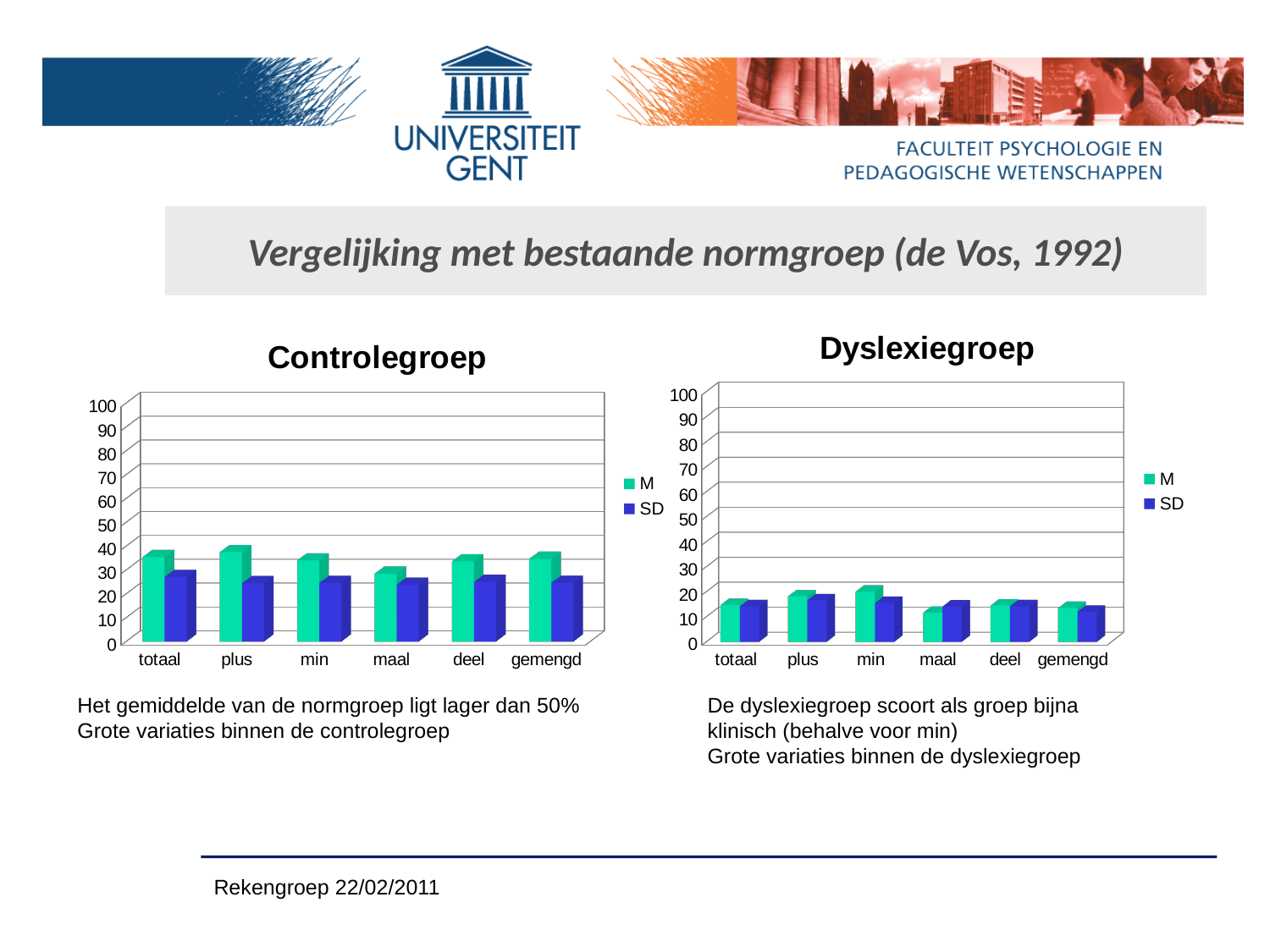
What are the two legend entries in the Controlegroep chart? M and SD In the Dyslexiegroep chart, is the M value for min greater or less than 10? greater In the Dyslexiegroep chart, which is larger for maal: M or SD? SD In the Dyslexiegroep chart, which category has the highest M value? min How many categories are shown on the x axis of the Controlegroep chart? 6 In the Dyslexiegroep chart, is the M value for plus greater or less than 30? less In the Controlegroep chart, is the M value for totaal greater or less than 30? greater In the Controlegroep chart, which category has the lowest M value? maal In the Controlegroep chart, which is larger for totaal: M or SD? M How many series does the legend of the Dyslexiegroep chart list? 2 In the Dyslexiegroep chart, which category has the lowest M value? maal What kind of chart is the Controlegroep chart? bar chart